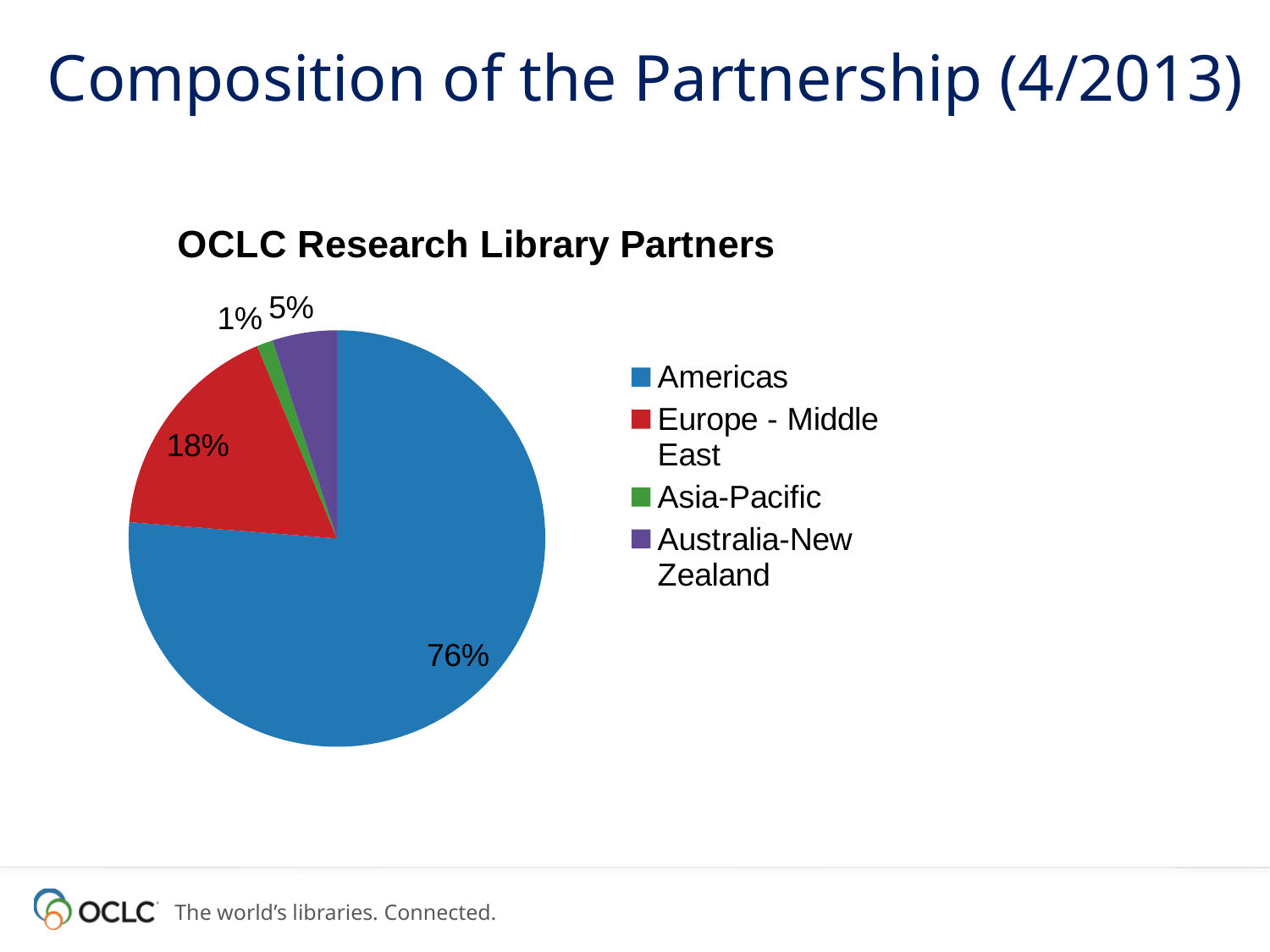
What colour is the slice for Europe - Middle East? Red Which has a larger share, Australia-New Zealand or Asia-Pacific? Australia-New Zealand What share of the pie does Europe - Middle East represent? 18% What type of chart is shown on the slide? Pie chart What share of the pie does Americas represent? 76% What is the difference in percentage points between the Americas share and the Europe - Middle East share? 58 What is the title of the chart? OCLC Research Library Partners Which region has the largest share of the pie? Americas What share of the pie does Asia-Pacific represent? 1% Which region has the smallest share of the pie? Asia-Pacific How many regions are shown in the pie chart? 4